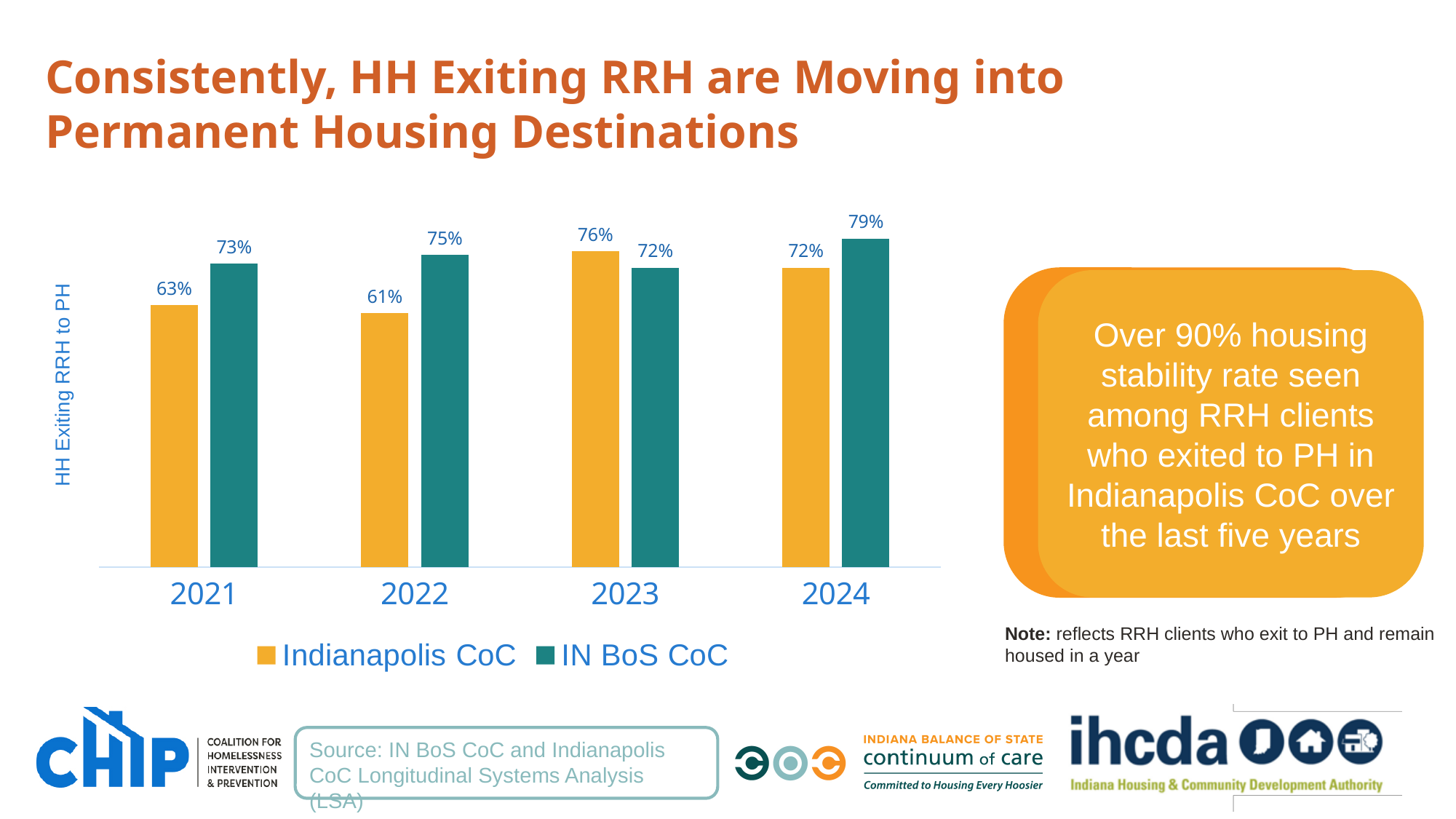
In which year is the Indianapolis CoC value lowest? 2022 How many series does the legend list? 2 In 2023, which series has the larger value, Indianapolis CoC or IN BoS CoC? Indianapolis CoC What kind of chart is shown on the slide? Bar chart What is the difference between the IN BoS CoC and Indianapolis CoC values in 2022? 14% In which year is the Indianapolis CoC value highest? 2023 Does the IN BoS CoC value rise or fall from 2023 to 2024? Rise What is the value for IN BoS CoC in 2022? 75% What is the label on the vertical axis of the chart? HH Exiting RRH to PH What is the value for Indianapolis CoC in 2021? 63% How many years are shown on the x axis? 4 What is the value for IN BoS CoC in 2024? 79%